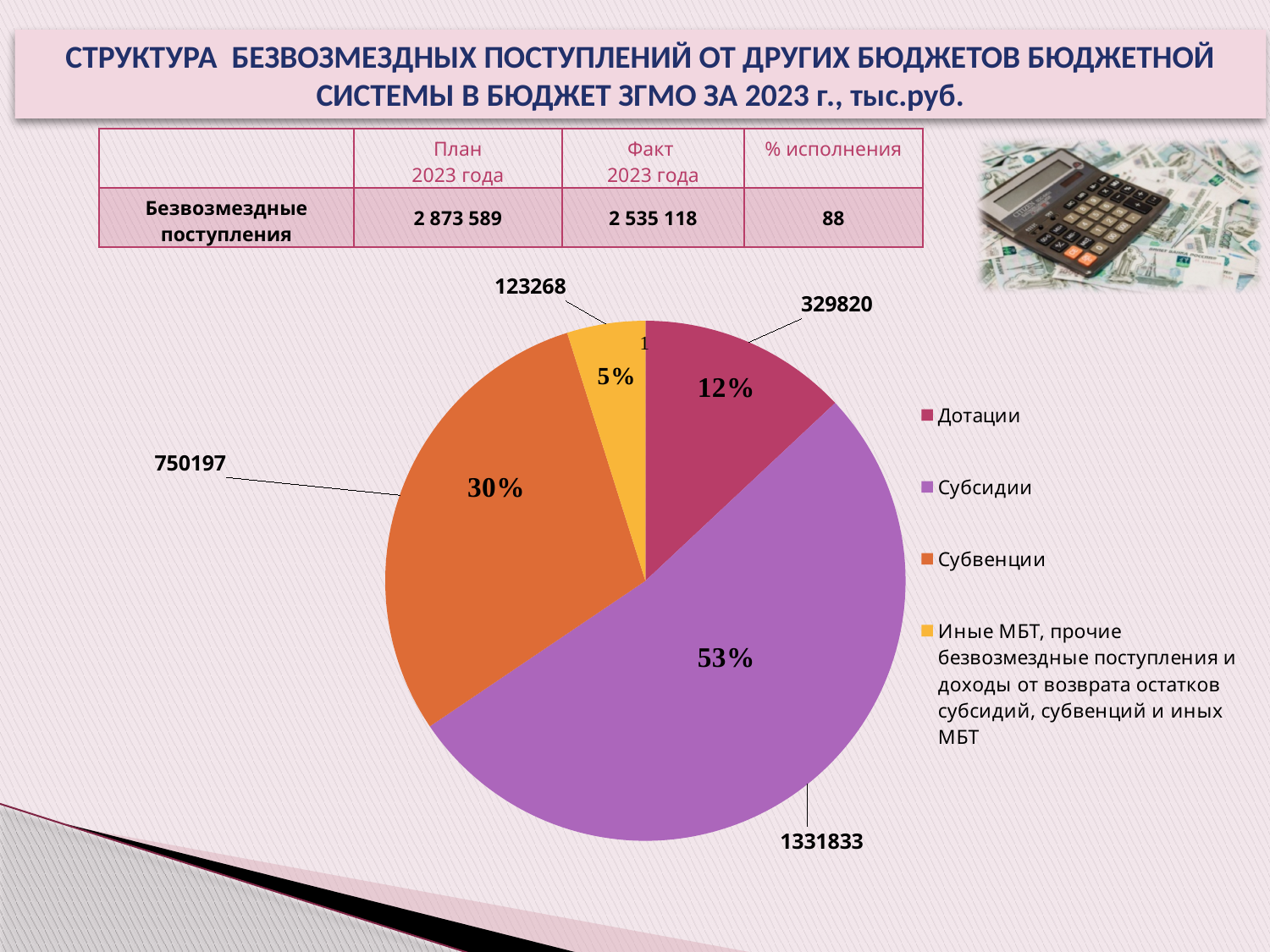
What share of the pie does Субвенции account for? 30% How many entries does the legend of the pie chart list? 4 How many slices does the pie chart have? 4 What is the value for Дотации in the pie chart? 329820 Which category has the smallest slice in the pie chart? Иные МБТ, прочие безвозмездные поступления и доходы от возврата остатков субсидий, субвенций и иных МБТ What is the difference between the values for Субсидии and Субвенции in the pie chart? 581636 Which is larger in the pie chart, Дотации or Субвенции? Субвенции What share of the pie does Дотации account for? 12% What kind of chart is shown on the slide? pie chart What is the value for Субсидии in the pie chart? 1331833 Which category has the largest slice in the pie chart? Субсидии What is the value for Субвенции in the pie chart? 750197